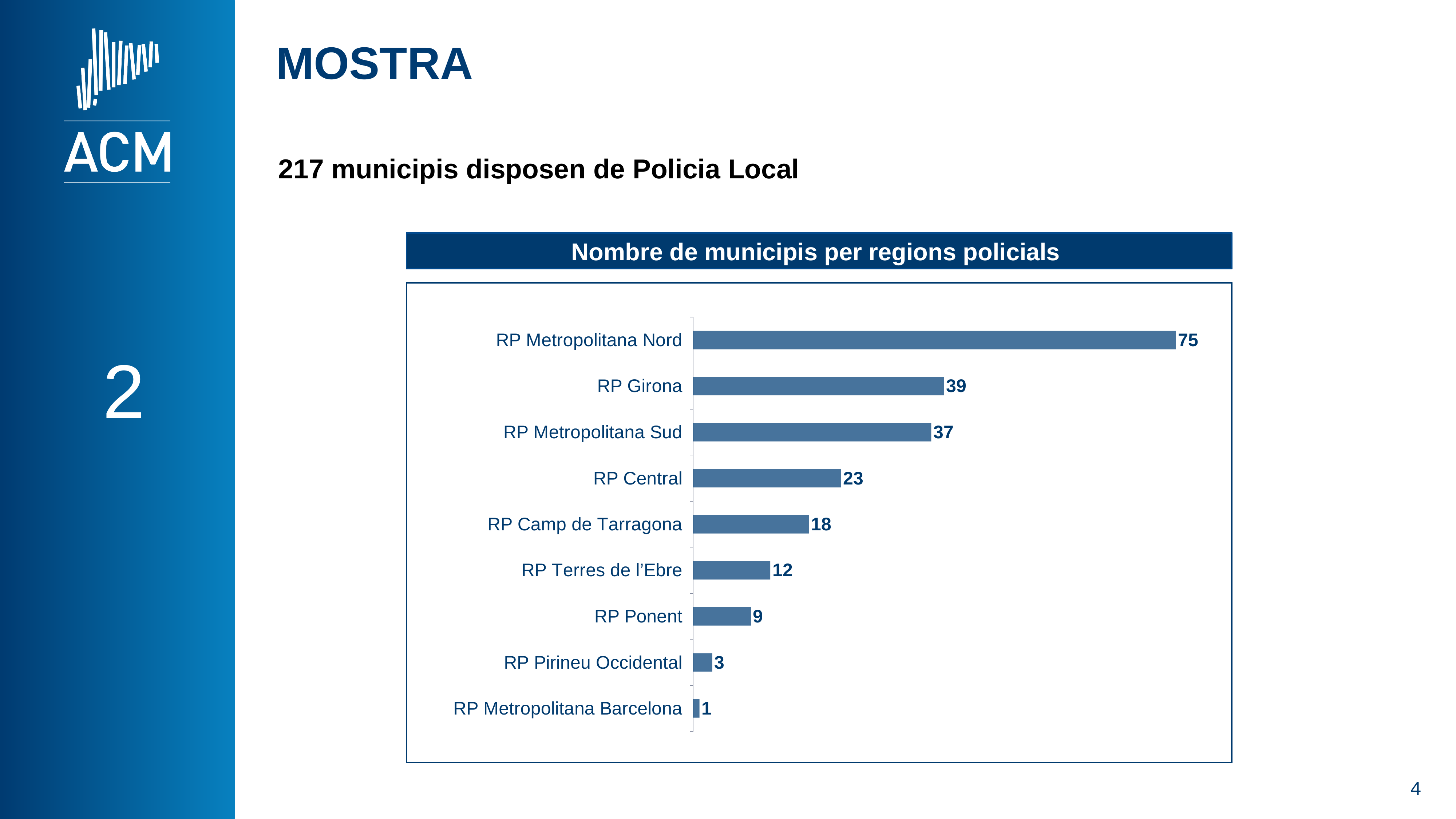
What is the difference between the values for RP Metropolitana Nord and RP Camp de Tarragona? 57 What is the value for RP Metropolitana Nord? 75 What is the value for RP Girona? 39 What is the value for RP Terres de l'Ebre? 12 Which is larger, the value for RP Ponent or the value for RP Pirineu Occidental? RP Ponent Which region has the lowest number of municipalities? RP Metropolitana Barcelona Which region has the highest number of municipalities? RP Metropolitana Nord What is the title of the chart? Nombre de municipis per regions policials What is the difference between the values for RP Girona and RP Metropolitana Sud? 2 What kind of chart is shown on the slide? bar chart What is the value for RP Central? 23 How many regions are shown in the chart? 9